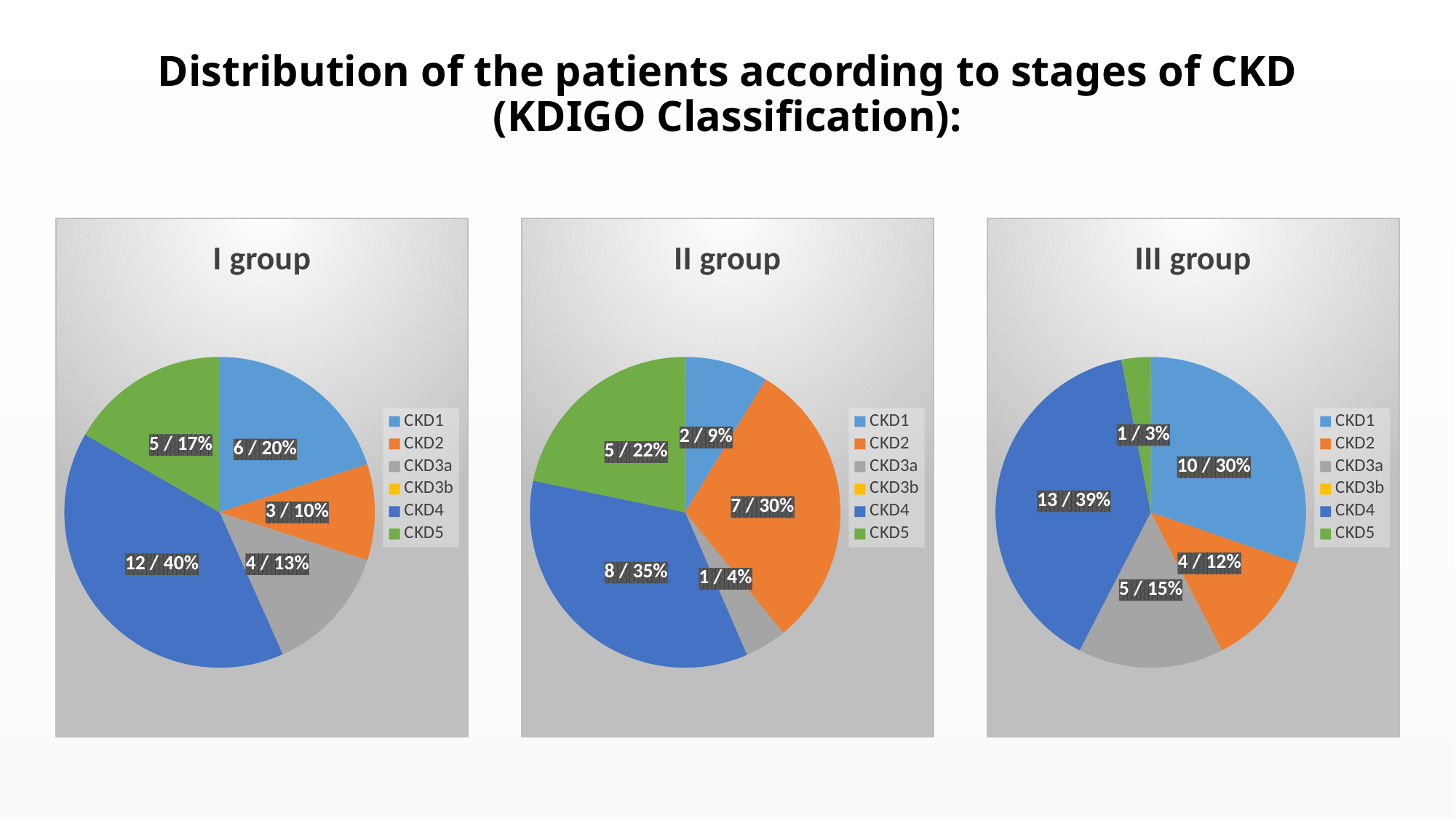
In the I group chart, what is the data label shown for the CKD4 slice? 12 / 40% In the I group chart, how many more patients are in CKD4 than in CKD5? 7 In the I group chart, what colour is the CKD5 slice? Green In the III group chart, what is the data label shown for the CKD5 slice? 1 / 3% In the I group chart, what share of the pie does the CKD1 slice represent? 20% How many entries does the legend of the II group chart list? 6 In the III group chart, which CKD stage has the largest slice? CKD4 In the II group chart, what is the data label shown for the CKD2 slice? 7 / 30% In the II group chart, which CKD stage has the smallest visible slice? CKD3a In the II group chart, how many patients are in CKD4? 8 What type of chart is used for the III group? Pie chart In the III group chart, which slice is larger, CKD1 or CKD3a? CKD1